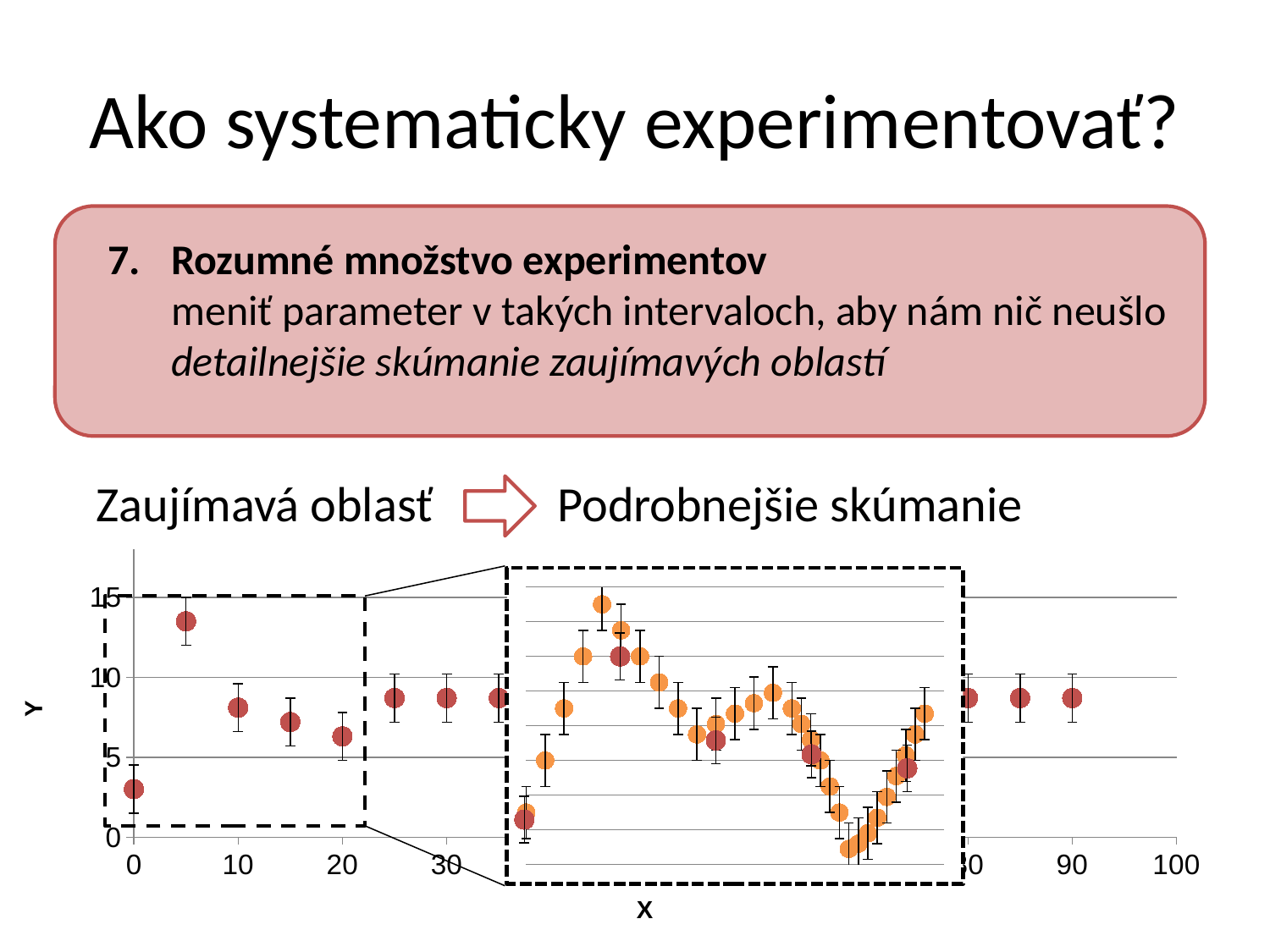
In the main chart, is the value for X = 5 greater or less than 10? greater In the main chart, is the value for X = 10 greater or less than 5? greater What kind of chart is shown at the bottom of the slide? scatter chart What is the title of the horizontal axis of the chart? X In the main chart, is the value for X = 20 greater or less than 10? less What is the title of the vertical axis of the chart? Y In the main chart, which X value has the lowest Y value among the red points? 0 In the main chart, which has the larger Y value: X = 5 or X = 20? X = 5 In the main chart, which X value has the highest Y value among the red points? 5 In the main chart, do the red points rise or fall from X = 5 to X = 20? fall